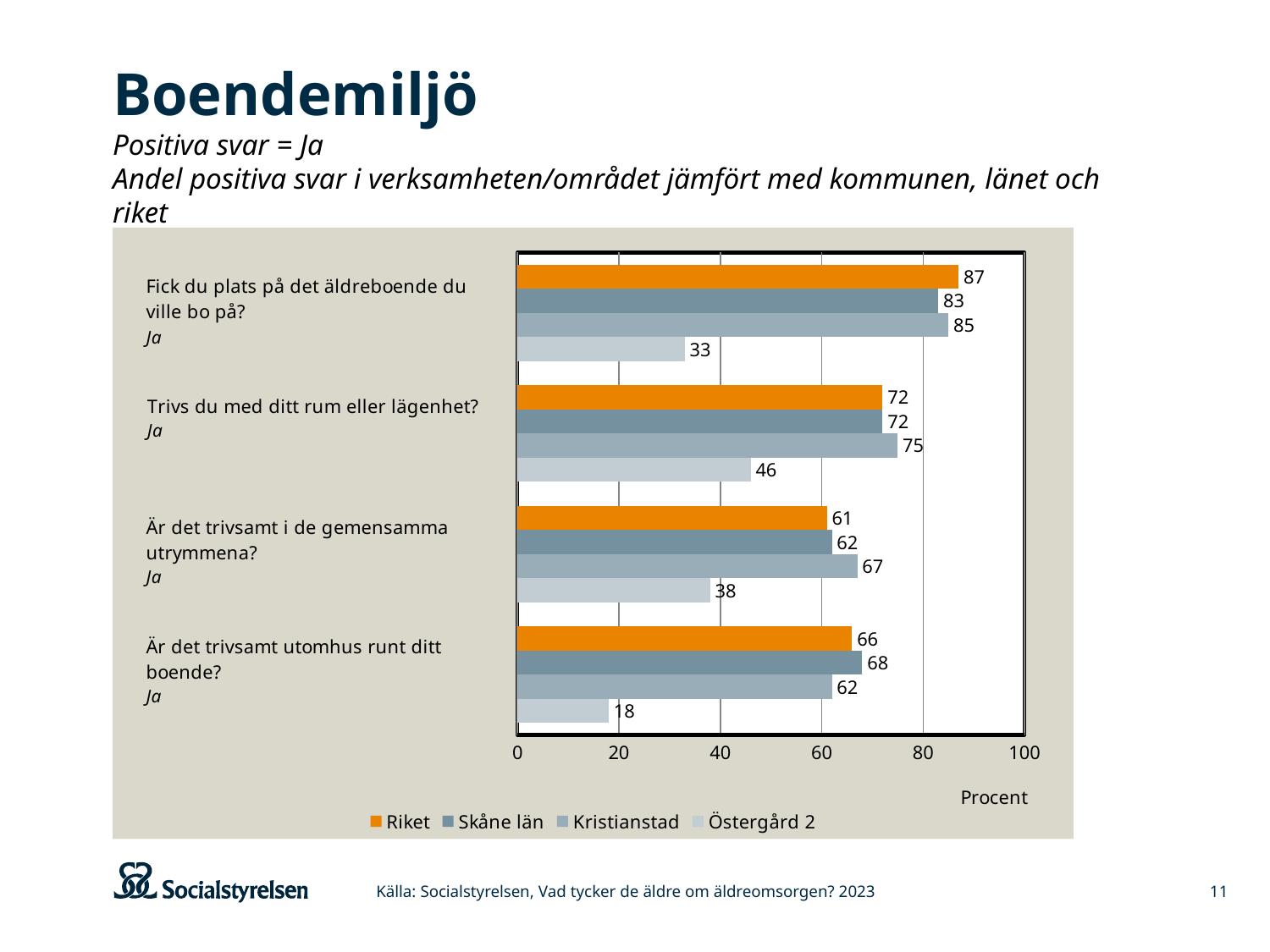
How many questions (categories) are shown on the chart? 4 What is the difference between Riket and Östergård 2 on "Är det trivsamt utomhus runt ditt boende?"? 48 Is the value for Östergård 2 on "Trivs du med ditt rum eller lägenhet?" greater or less than 40? greater What is the value for Riket on "Är det trivsamt utomhus runt ditt boende?"? 66 What is the label on the horizontal axis of the chart? Procent Which question has the lowest value for Östergård 2? Är det trivsamt utomhus runt ditt boende? What is the value for Östergård 2 on "Fick du plats på det äldreboende du ville bo på?"? 33 How many series does the legend list? 4 Which series has the highest value on "Fick du plats på det äldreboende du ville bo på?"? Riket Which is larger on "Är det trivsamt i de gemensamma utrymmena?": Kristianstad or Skåne län? Kristianstad What kind of chart is shown on the slide? Bar chart What is the value for Kristianstad on "Trivs du med ditt rum eller lägenhet?"? 75